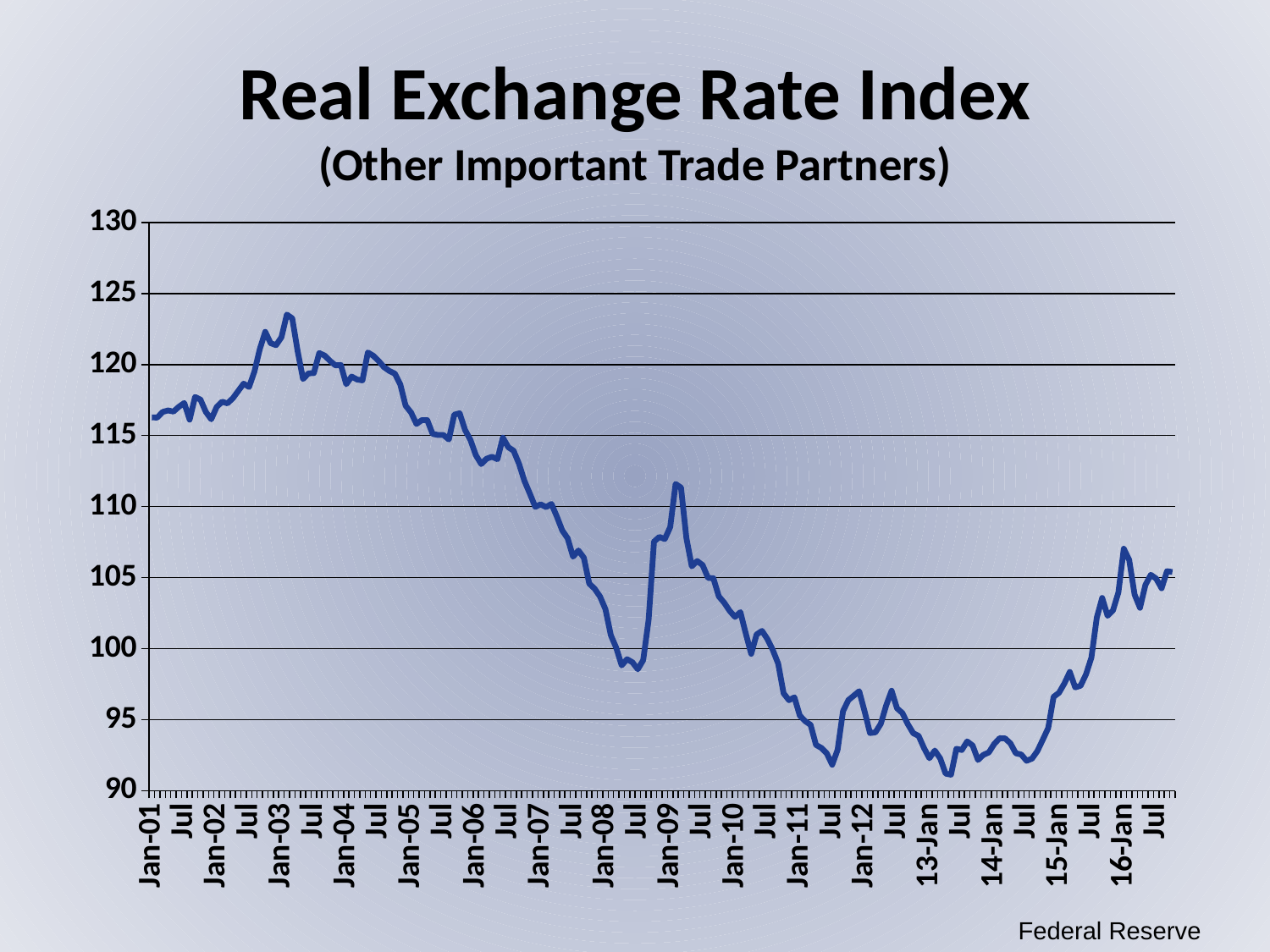
Is the value at Jul-08 greater or less than 100? less Is the value at Jul-11 greater or less than 95? less Which is larger, the value at Jan-03 or the value at 13-Jan? Jan-03 What kind of chart is shown on the slide? line chart Is the value at Jan-01 greater or less than 115? greater Overall, does the index rise or fall between Jan-01 and the end of the series in 2016? fall In which year does the line reach its highest point? 2003 What source is cited for the chart? Federal Reserve What is the title of the chart? Real Exchange Rate Index (Other Important Trade Partners)